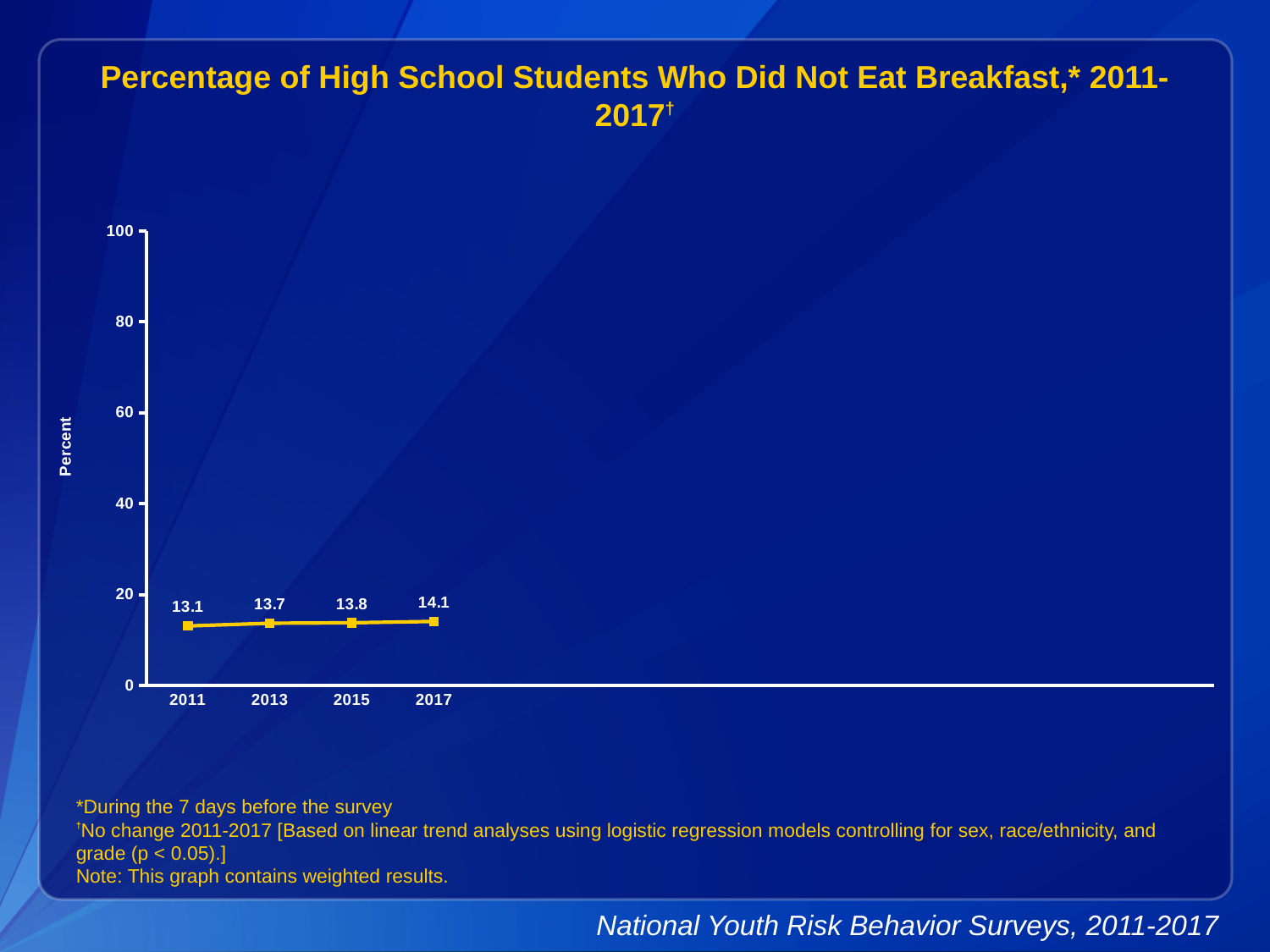
What is the value plotted for 2017? 14.1 How many years are plotted on the chart? 4 What is the label on the vertical axis? Percent What percentage of high school students did not eat breakfast in 2011? 13.1 What kind of chart is shown on the slide? line chart What is the value plotted for 2013? 13.7 What is the value plotted for 2015? 13.8 What is the difference between the 2017 value and the 2011 value? 1.0 Which year has the highest value on the chart? 2017 Which is larger, the value for 2013 or the value for 2017? 2017 Is the value for 2015 greater or less than 20? less Which year has the lowest value on the chart? 2011